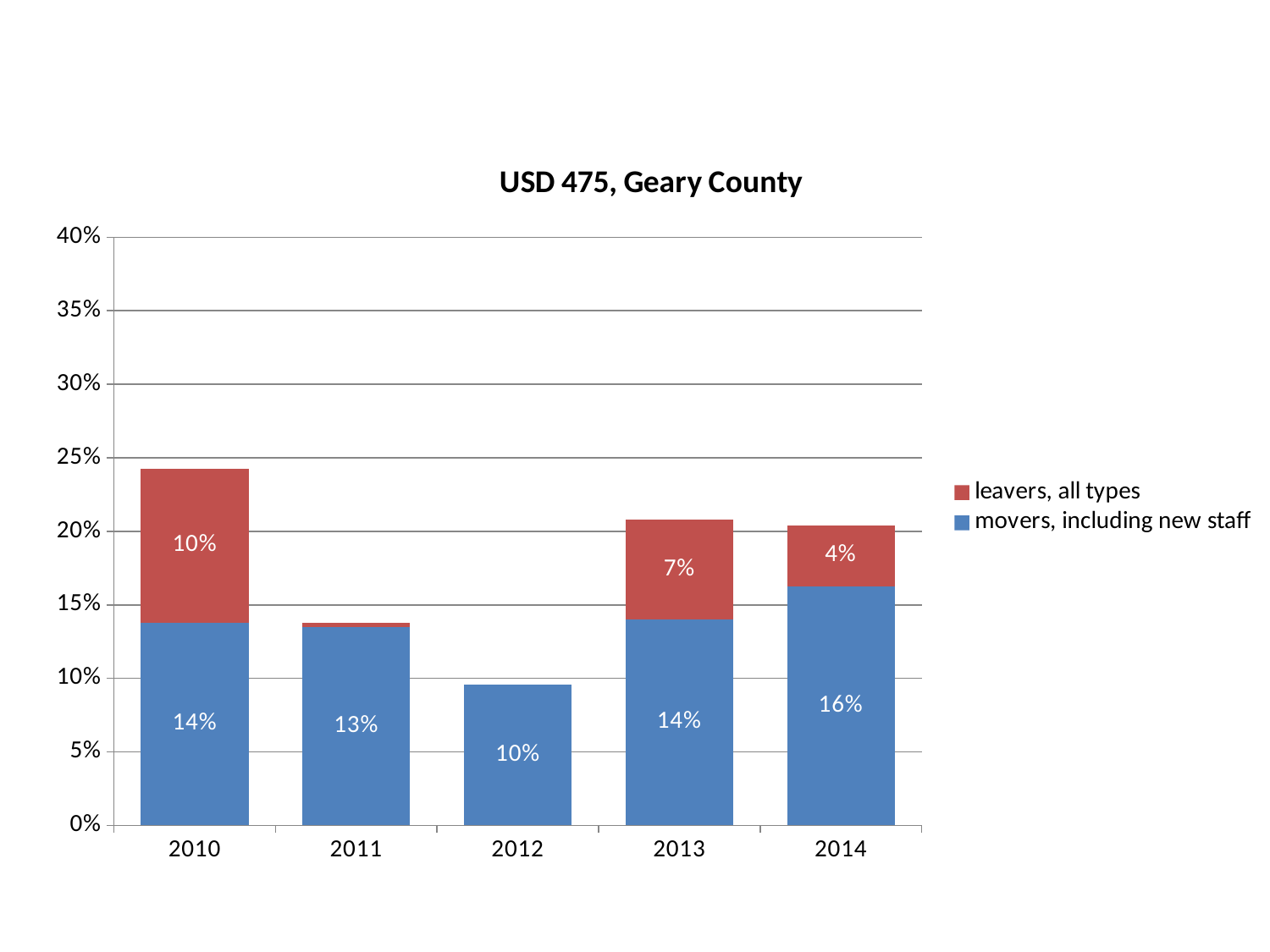
How many years are shown on the x axis? 5 What is the value for movers, including new staff in 2014? 16% Which year has the highest value for movers, including new staff? 2014 Which year has the highest labelled value for leavers, all types? 2010 What is the difference between the movers, including new staff values for 2014 and 2012? 6% Is the leavers, all types value larger in 2010 or in 2014? 2010 Which year has the lowest value for movers, including new staff? 2012 What is the title of the chart? USD 475, Geary County What is the value for leavers, all types in 2013? 7% What type of chart is shown on the slide? stacked bar chart Is the total height of the 2011 bar greater or less than 15%? less How many series does the legend list? 2